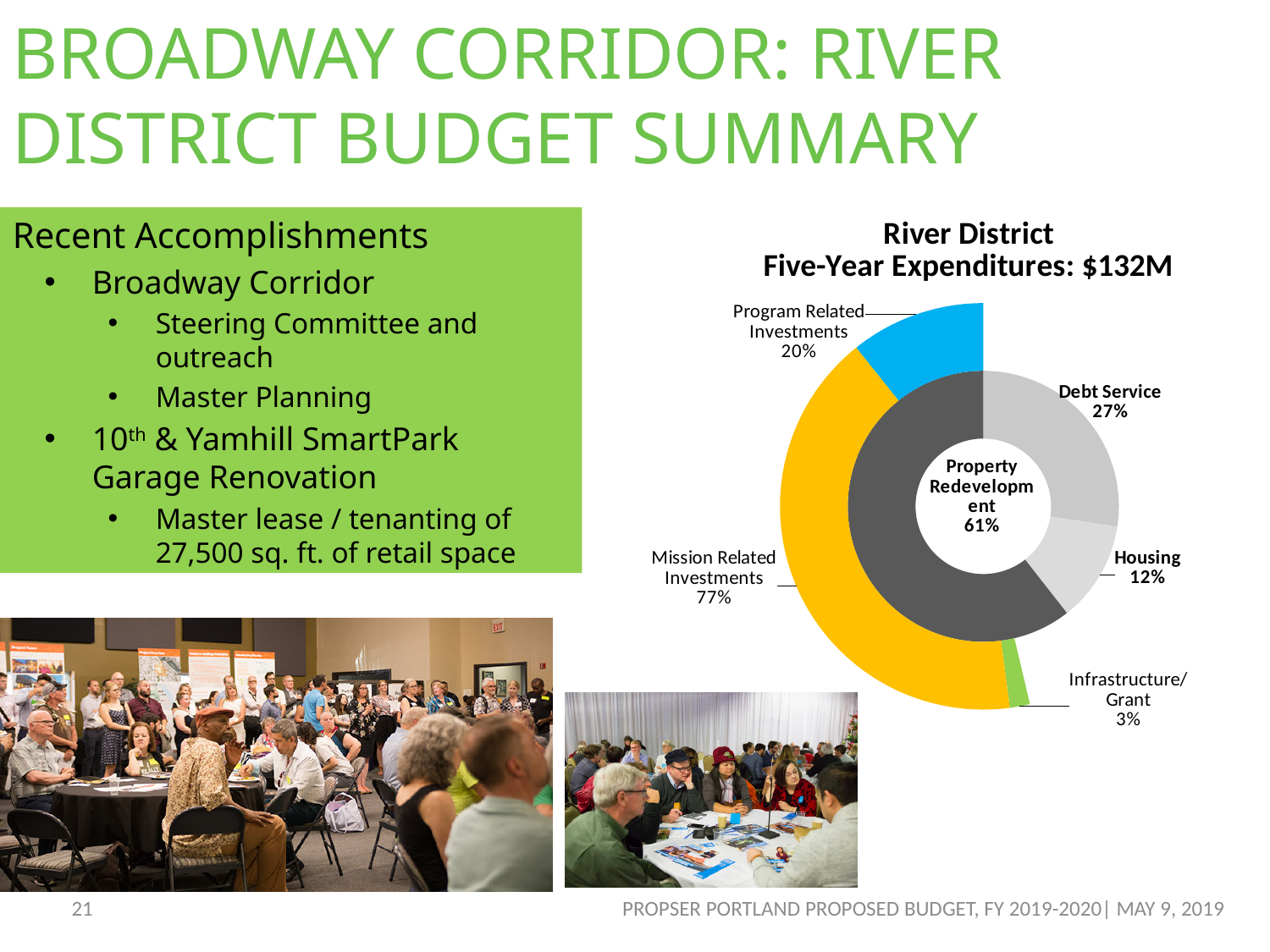
What kind of chart is shown on the slide? Doughnut chart What percentage is shown for Infrastructure/Grant? 3% What is the title of the chart? River District Five-Year Expenditures: $132M Which category in the inner ring has the largest share? Property Redevelopment What percentage is shown for Mission Related Investments? 77% Which is larger, Mission Related Investments or Program Related Investments? Mission Related Investments What percentage of the inner ring is Property Redevelopment? 61% What percentage is shown for Program Related Investments? 20% What is the difference in percentage points between Debt Service and Housing? 15 percentage points Which category in the outer ring has the smallest share? Infrastructure/Grant What percentage is shown for Debt Service? 27% What percentage is shown for Housing? 12%